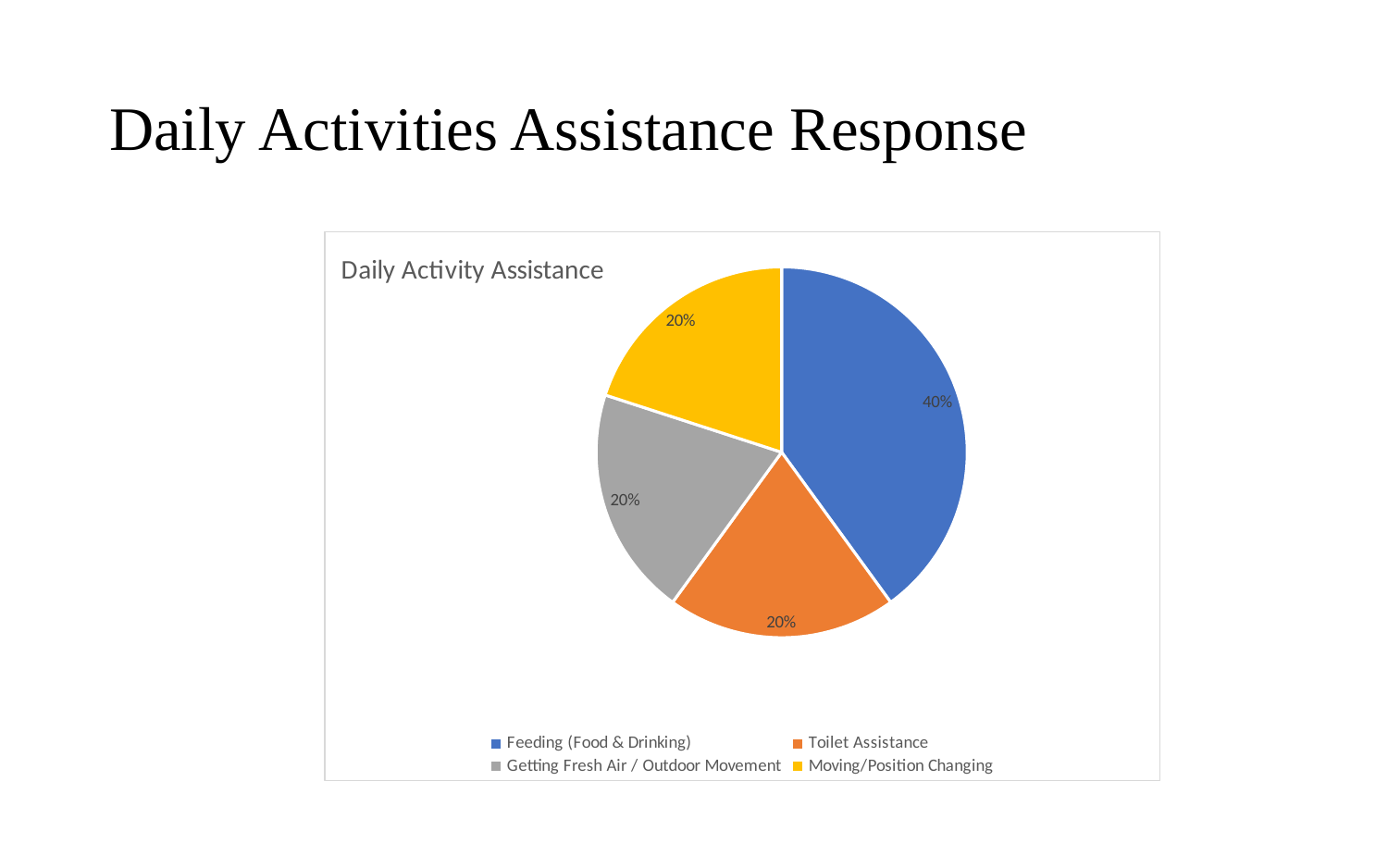
What is the title of the chart? Daily Activity Assistance What share of the pie does Moving/Position Changing represent? 20% What share of the pie does Toilet Assistance represent? 20% How many categories does the pie chart show? 4 Which colour represents Toilet Assistance in the pie chart? Orange What kind of chart is shown on the slide? Pie chart How many entries does the legend list? 4 Which category has the largest slice of the pie? Feeding (Food & Drinking) What share of the pie does Getting Fresh Air / Outdoor Movement represent? 20% What is the difference between the share for Feeding (Food & Drinking) and the share for Toilet Assistance? 20% Which is larger, the share for Feeding (Food & Drinking) or the share for Moving/Position Changing? Feeding (Food & Drinking)